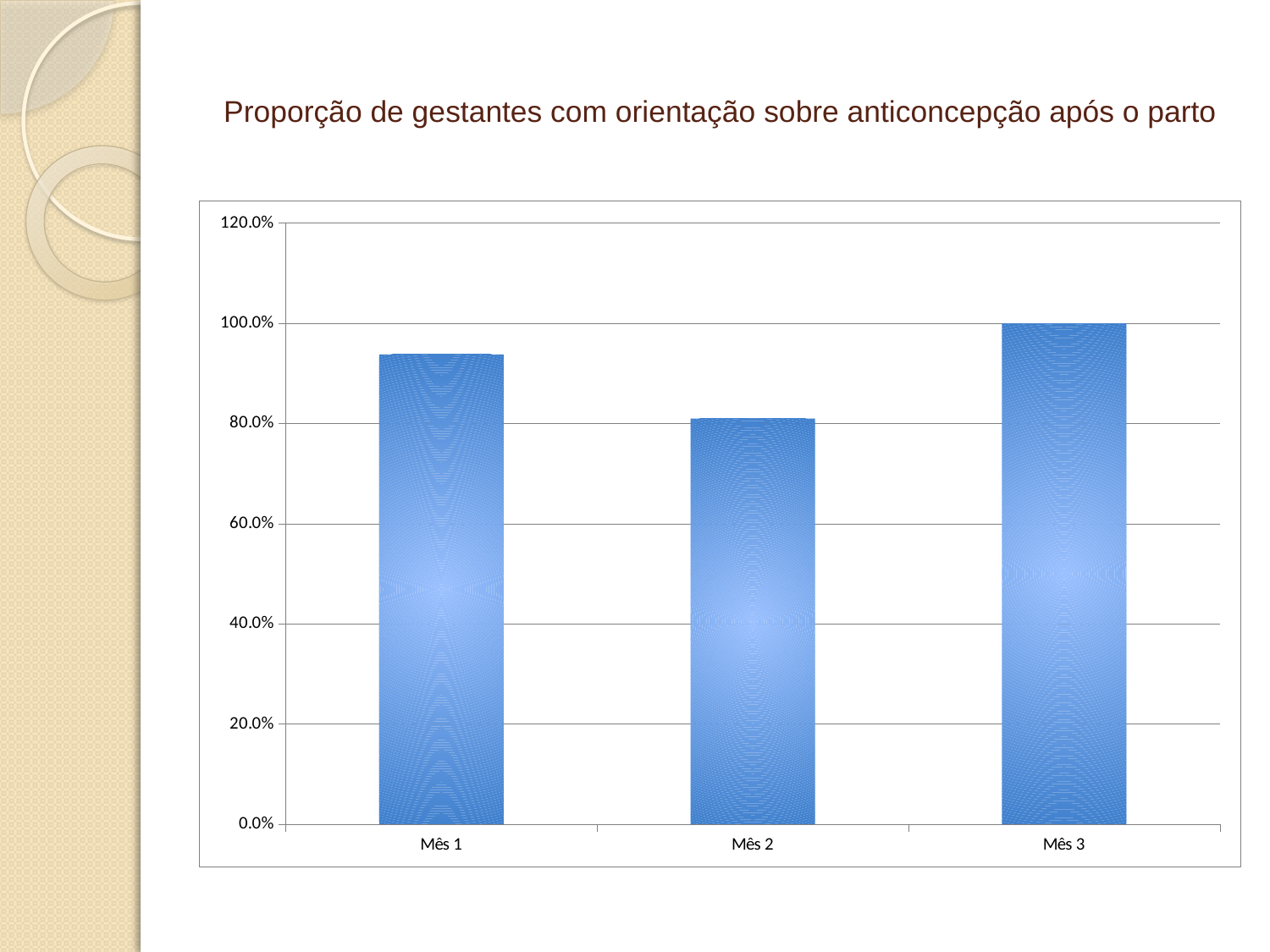
Is the value for Mês 2 greater or less than 100.0%? less Which month has the lowest value in the chart? Mês 2 Which is larger, the value for Mês 1 or the value for Mês 2? Mês 1 What is the highest value shown on the y axis of the chart? 120.0% Which month has the highest value in the chart? Mês 3 Is the value for Mês 2 greater or less than 60.0%? greater What is the title of the slide above the chart? Proporção de gestantes com orientação sobre anticoncepção após o parto Is the value for Mês 1 greater or less than 80.0%? greater What kind of chart is shown on the slide? bar chart How many categories are shown on the x axis of the chart? 3 What is the value for Mês 3? 100.0%